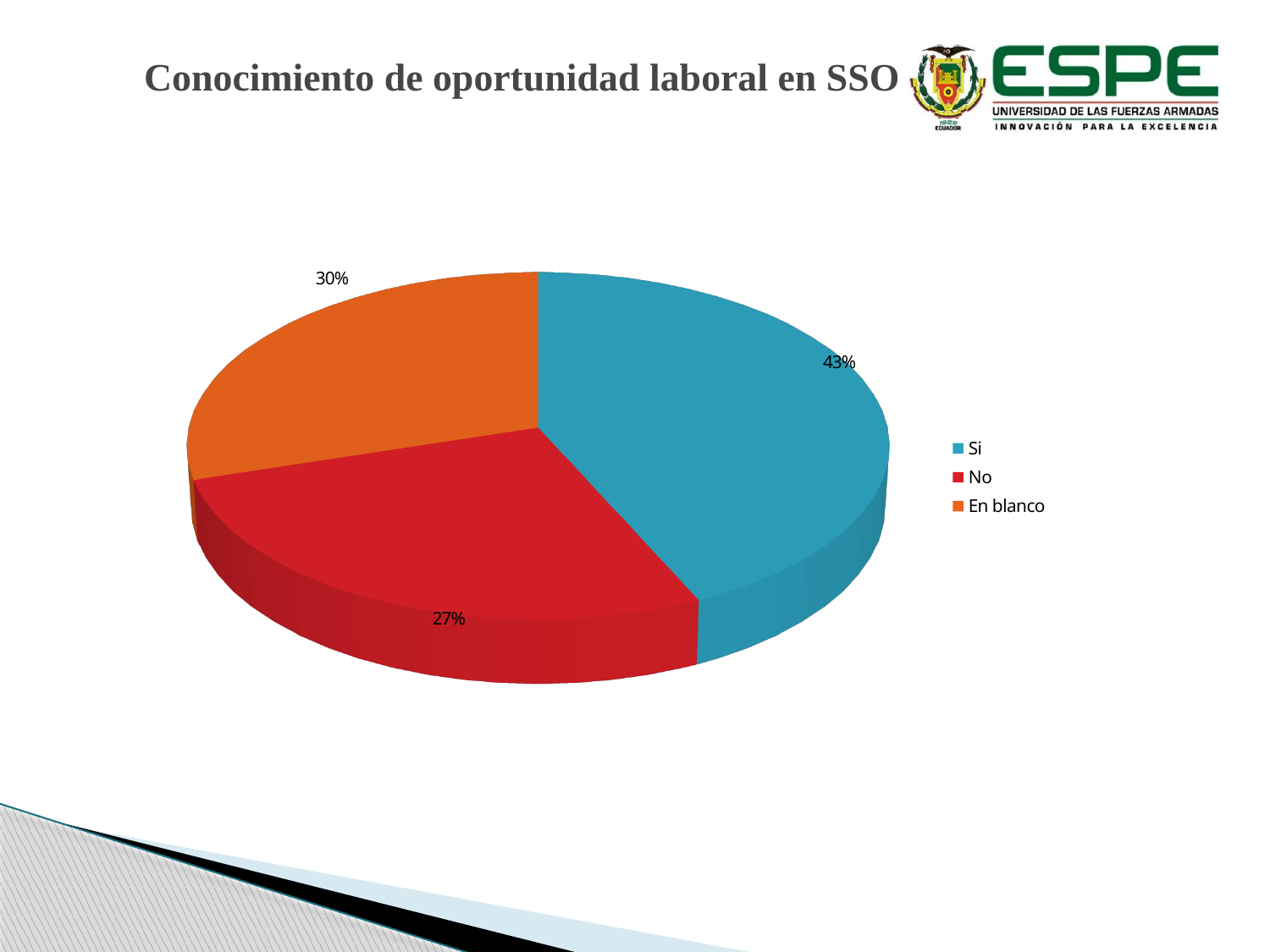
What share of the pie does the "En blanco" slice represent? 30% What share of the pie does the "No" slice represent? 27% What is the difference in percentage points between the "En blanco" slice and the "No" slice? 3 Which colour represents the "No" category in the legend? Red What is the difference in percentage points between the "Si" slice and the "No" slice? 16 Which category has the smallest slice of the pie? No Which category has the largest slice of the pie? Si What share of the pie does the "Si" slice represent? 43% How many categories does the pie chart show? 3 Which is larger, the "Si" slice or the "En blanco" slice? Si What kind of chart is shown on the slide? Pie chart What is the title of the chart on the slide? Conocimiento de oportunidad laboral en SSO